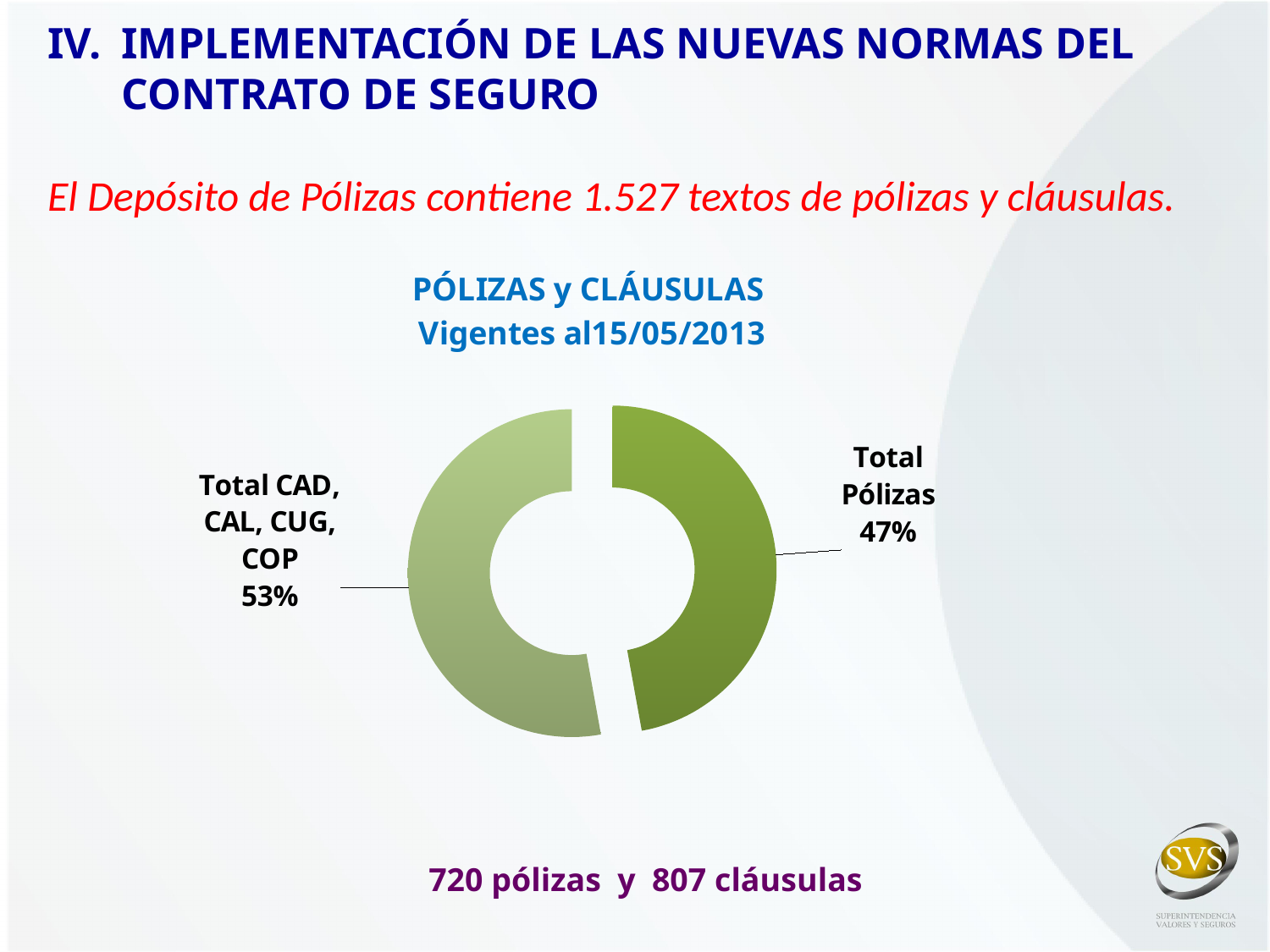
What is the title of the chart? PÓLIZAS y CLÁUSULAS Vigentes al15/05/2013 How many slices does the chart have? 2 Is the share for Total Pólizas greater or less than 50%? less Which slice is the largest in the chart? Total CAD, CAL, CUG, COP What share of the chart does Total CAD, CAL, CUG, COP represent? 53% What is the difference in percentage points between the Total CAD, CAL, CUG, COP slice and the Total Pólizas slice? 6 percentage points What is the combined share of the two slices in the chart? 100% Which slice is the smallest in the chart? Total Pólizas What share of the chart does Total Pólizas represent? 47% What kind of chart is shown on the slide? Doughnut chart Which is larger, the Total Pólizas slice or the Total CAD, CAL, CUG, COP slice? Total CAD, CAL, CUG, COP